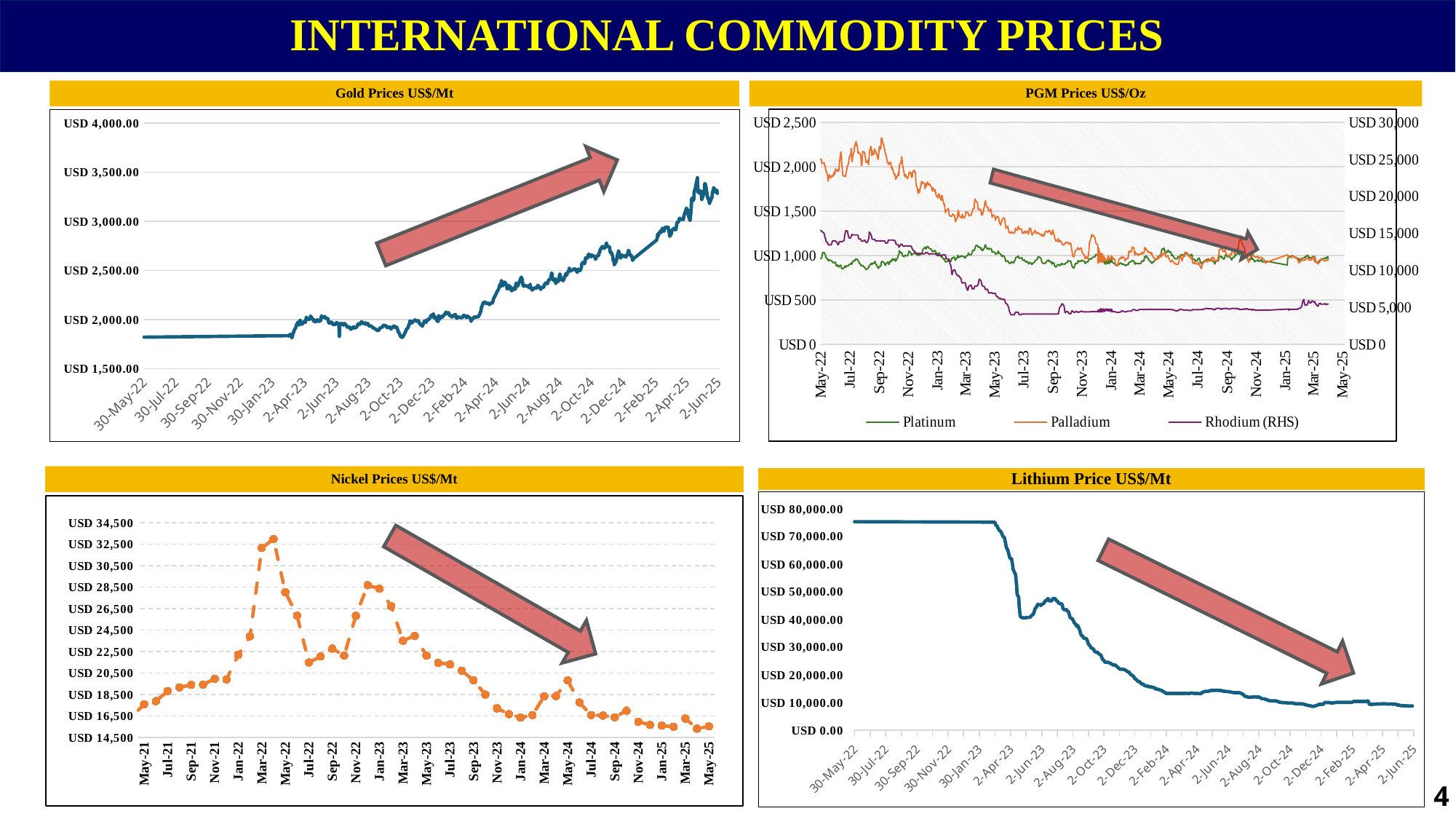
In the PGM Prices US$/Oz chart, which series is plotted against the right-hand axis? Rhodium (RHS) In the Gold Prices US$/Mt chart, is the value at 2-Jun-25 greater or less than USD 3,000.00? greater What kind of chart is the Gold Prices US$/Mt chart? line chart In the PGM Prices US$/Oz chart, is the Palladium value at May-22 greater or less than USD 1,500? greater In the Lithium Price US$/Mt chart, is the value at 30-May-22 greater or less than USD 70,000.00? greater In the Lithium Price US$/Mt chart, do lithium prices rise or fall from 30-May-22 to 2-Jun-25? fall In the Nickel Prices US$/Mt chart, do nickel prices rise or fall overall from May-21 to May-25? fall How many series does the legend of the PGM Prices US$/Oz chart list? 3 What are the legend entries in the PGM Prices US$/Oz chart? Platinum, Palladium, Rhodium (RHS) In the Gold Prices US$/Mt chart, do gold prices generally rise or fall from 30-May-22 to 2-Jun-25? rise